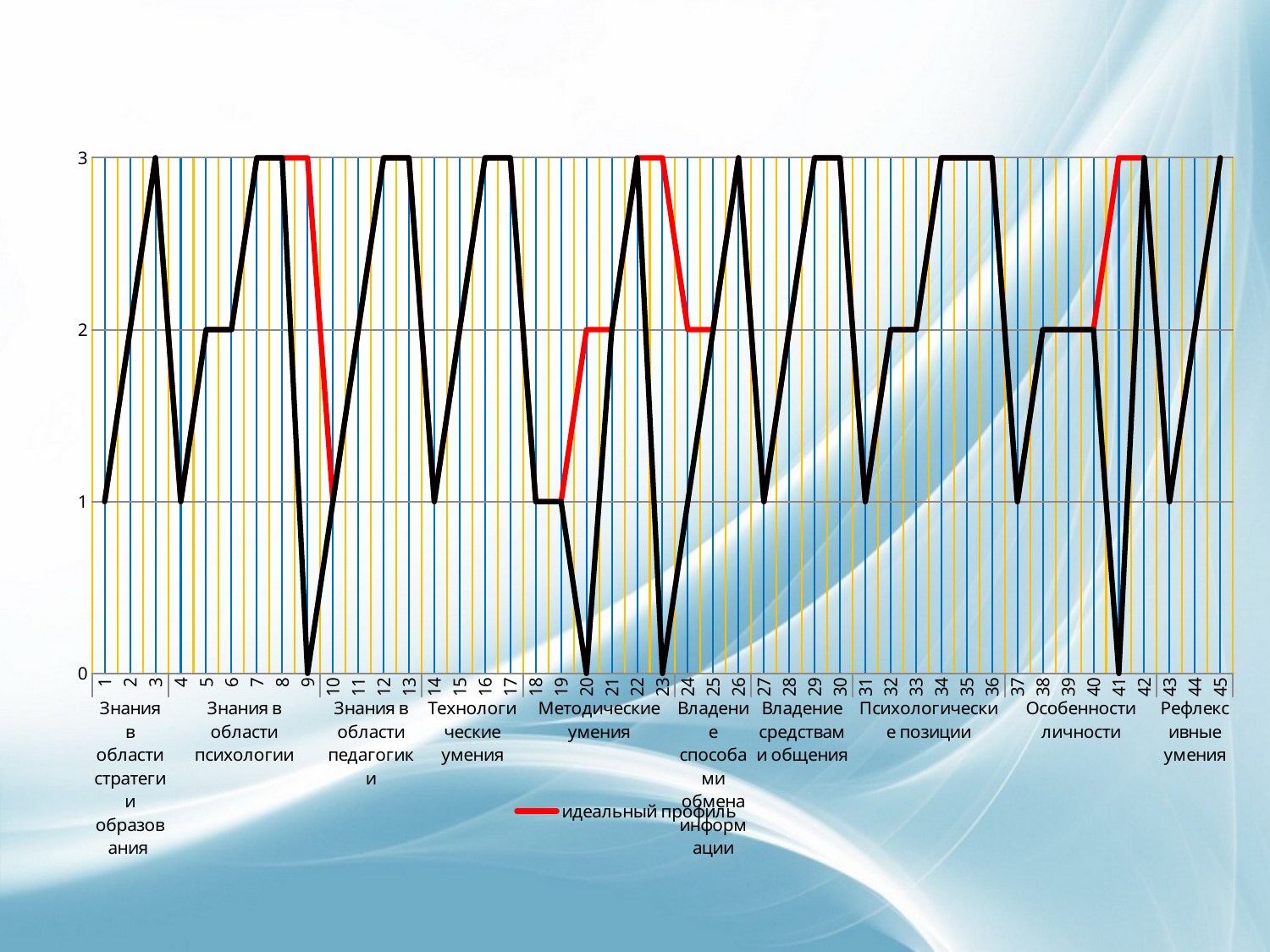
What kind of chart is shown on the slide? line chart What colour is the line for 'идеальный профиль' in the legend? red What is the value of the red 'идеальный профиль' line at point 9? 3 Which is larger, the value at point 3 or the value at point 4? point 3 What is the value of the red 'идеальный профиль' line at point 23? 3 What is the value at point 1? 1 What is the difference between the value at point 3 and the value at point 4? 2 What is the name of the series shown in the legend? идеальный профиль What is the value of the black line at point 9? 0 How many numbered points are plotted along the x axis? 45 What is the value of the black line at point 20? 0 How many series does the legend list? 1